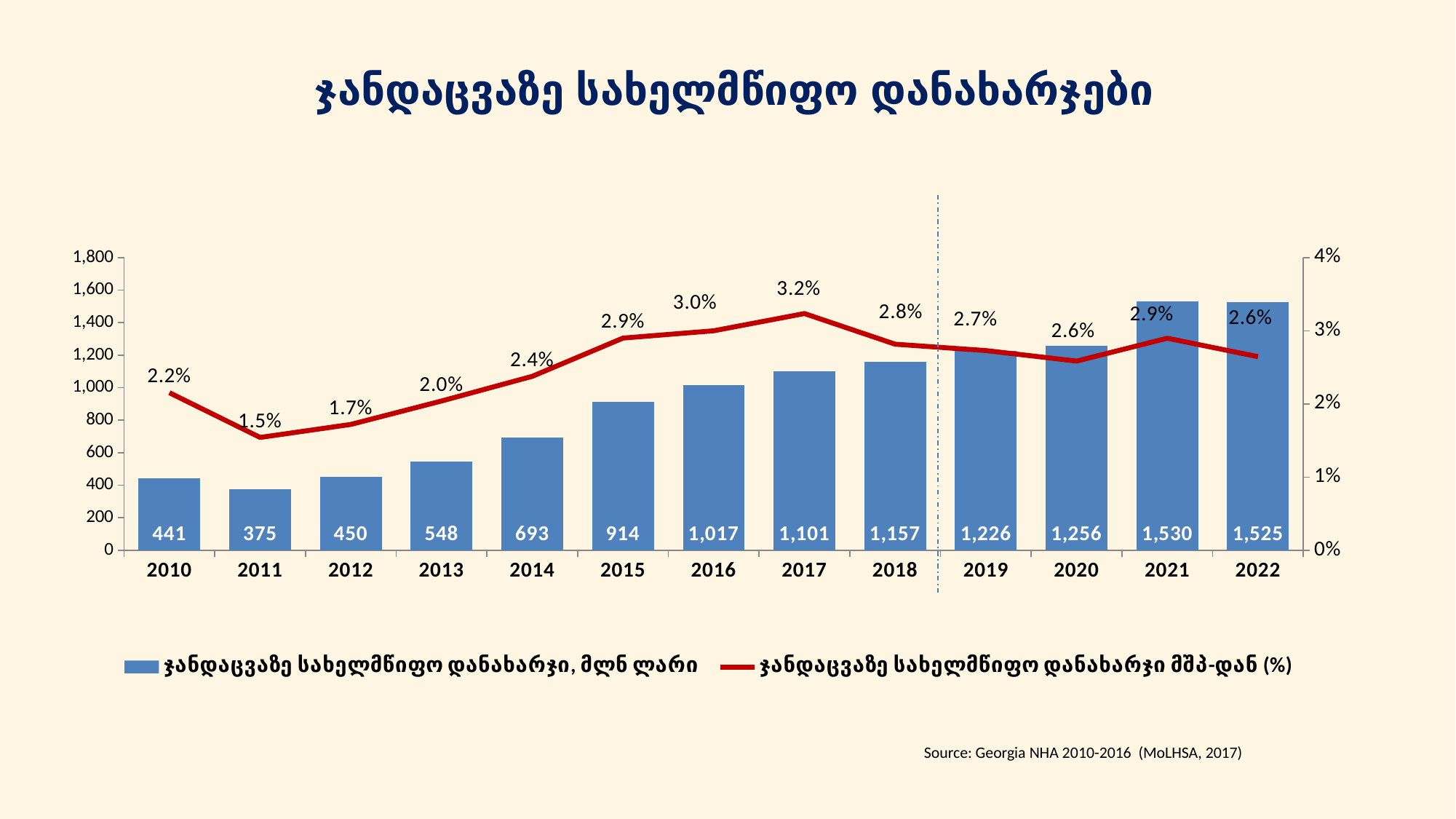
What is the difference between the bar values for 2021 and 2020? 274 Which is larger, the bar value for 2013 or for 2014? 2014 What is the value of the bar for 2015? 914 Do the bar values generally rise or fall from 2011 to 2021? Rise How many years are shown on the x axis? 13 In which year does the line series reach its lowest percentage? 2011 Which year has the lowest bar value? 2011 What percentage does the line series show for 2017? 3.2% Which year has the highest bar value? 2021 What is the value of the bar for 2022? 1,525 How many series does the legend list? 2 What kind of chart is shown on the slide? Combined bar and line chart